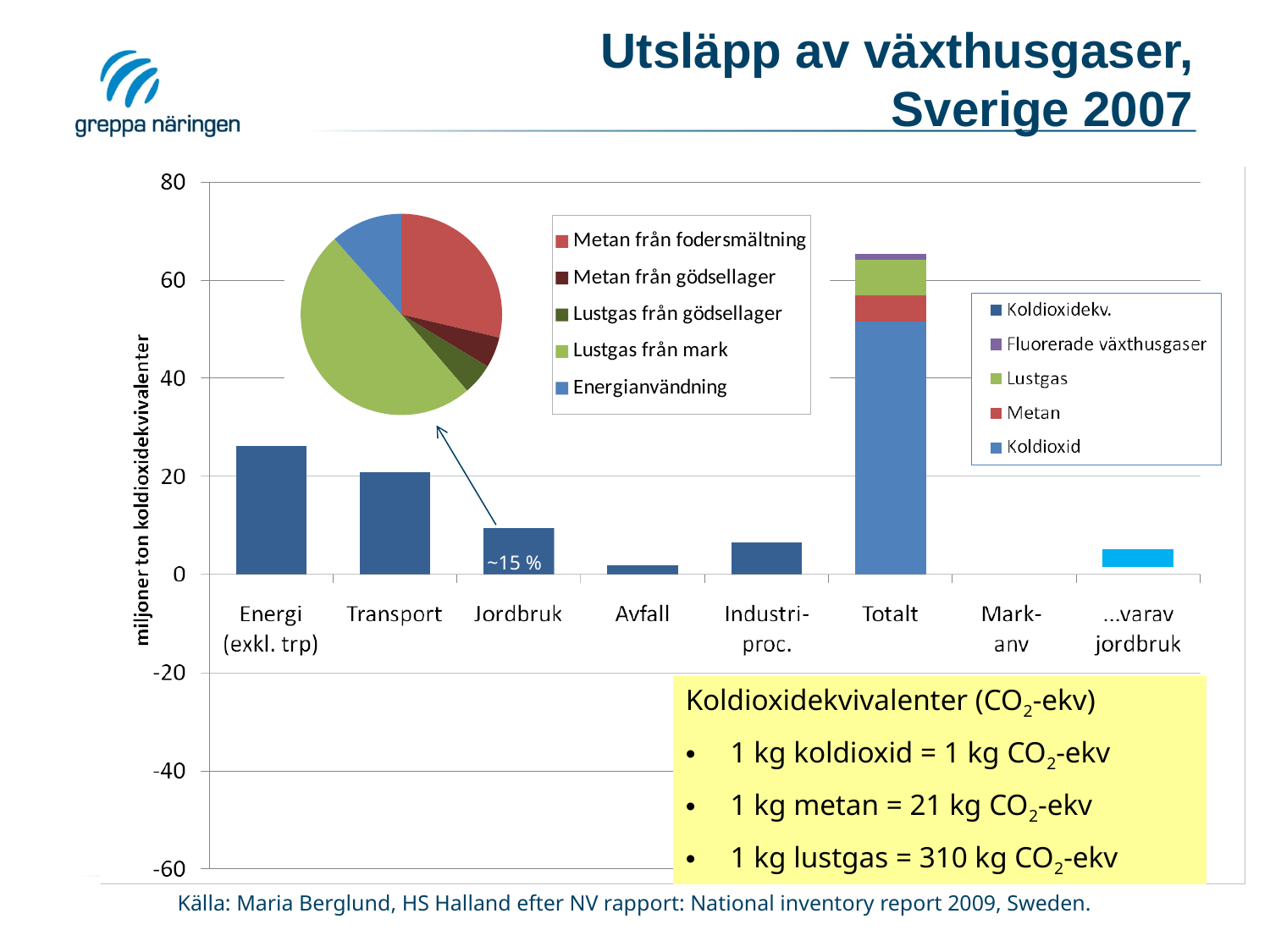
In the pie chart, which slice is the largest? Lustgas från mark In the bar chart, is the value for Totalt greater or less than 60? greater In the bar chart, which is lower, Avfall or Industri-proc.? Avfall In the bar chart, which is larger, Energi (exkl. trp) or Transport? Energi (exkl. trp) In the bar chart, which category has the highest bar? Totalt In the bar chart, is the value for Energi (exkl. trp) greater or less than 20? greater In the bar chart, how many categories are shown on the x axis? 8 How many series does the legend of the bar chart list? 5 How many entries does the legend of the pie chart list? 5 What kind of chart is the inset chart in the upper left of the plot area? pie chart What kind of chart is the main chart on the slide? bar chart In the bar chart, is the value for Jordbruk greater or less than 20? less